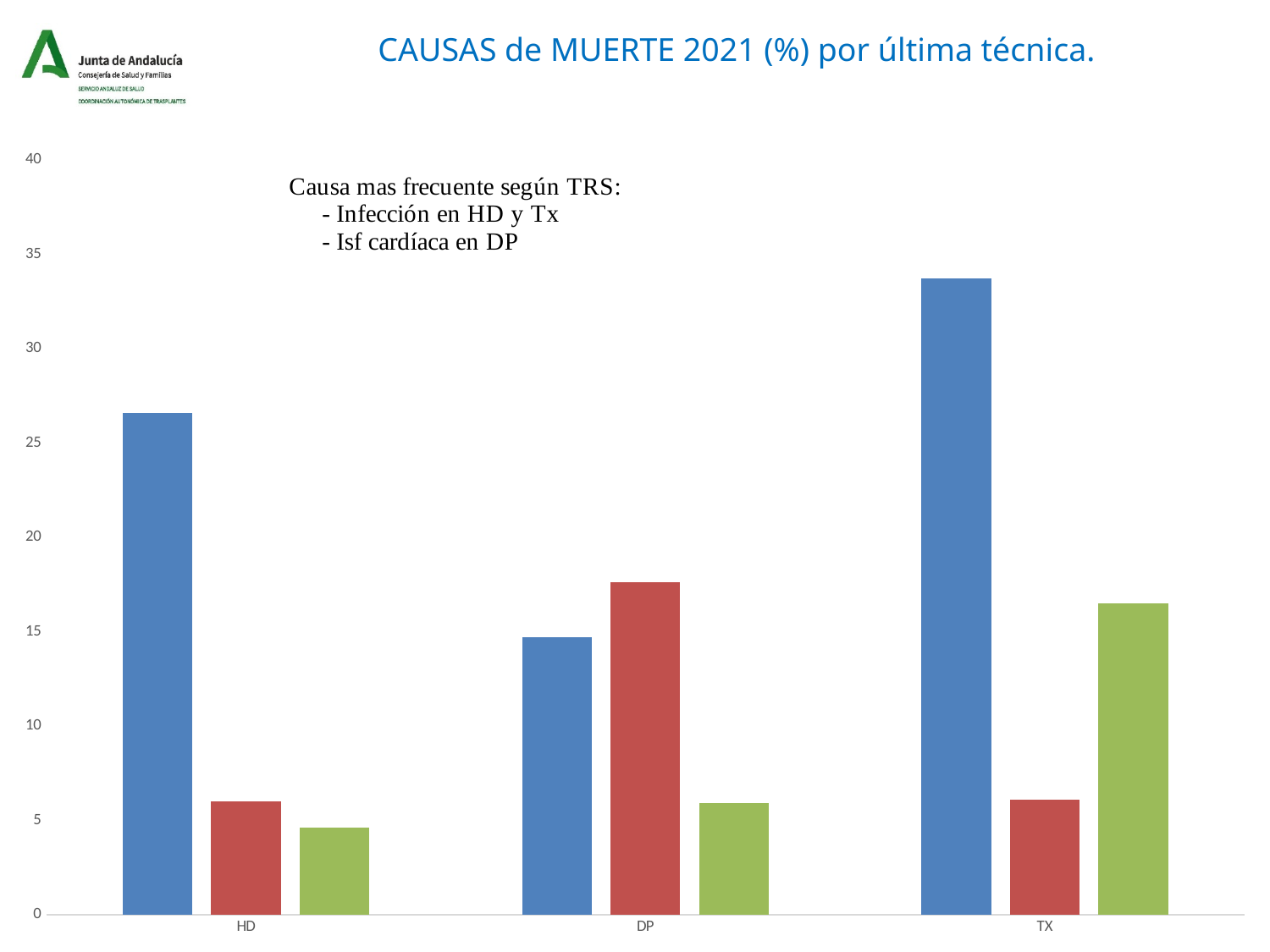
How many categories are shown on the x axis of the chart? 3 Which category has the shortest blue bar? DP Is the value of the blue bar for TX greater or less than 30? greater In the DP category, which bar is taller, the blue bar or the red bar? the red bar Is the value of the green bar for HD greater or less than 5? less In the TX category, which bar is taller, the red bar or the green bar? the green bar Is the value of the red bar for DP greater or less than 15? greater What is the title of the chart on the slide? CAUSAS de MUERTE 2021 (%) por última técnica. Which category has the tallest blue bar? TX What kind of chart is shown on the slide? bar chart Which category has the tallest red bar? DP